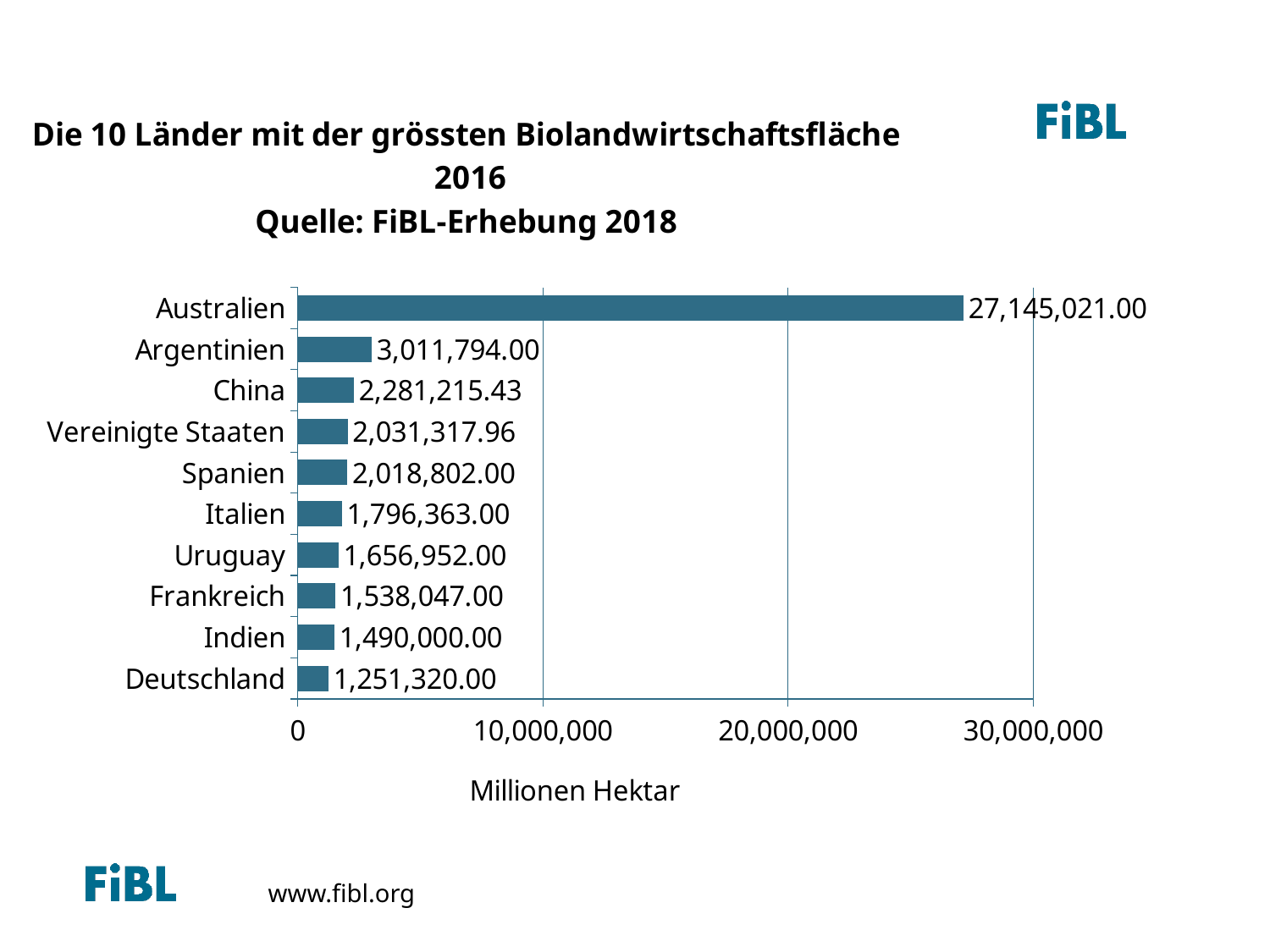
Which country has the largest organic farmland area? Australien Which country has the smallest value on the chart? Deutschland Which is larger, the value for China or the value for Italien? China What is the label of the x axis? Millionen Hektar What is the value for Australien? 27,145,021.00 What is the difference between the values for Australien and Argentinien? 24,133,227.00 What is the difference between the values for Indien and Deutschland? 238,680.00 Is the value for Australien greater or less than 20,000,000? greater What kind of chart is shown on the slide? bar chart How many countries are shown on the chart? 10 What is the value for China? 2,281,215.43 What is the value for Deutschland? 1,251,320.00